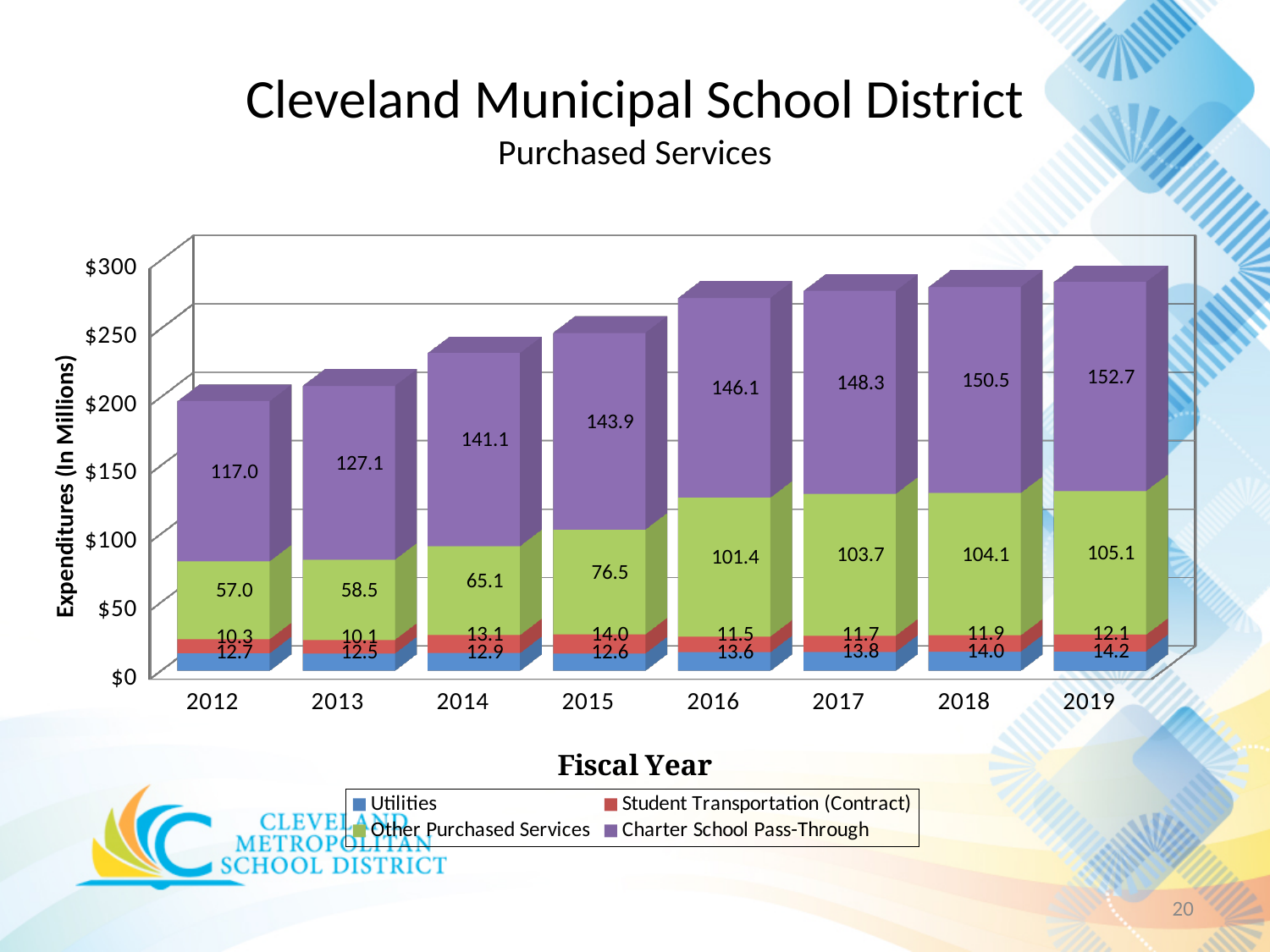
What is the Student Transportation (Contract) value for fiscal year 2015? 14.0 Which fiscal year has the highest Charter School Pass-Through value? 2019 How many series does the legend list? 4 What is the total of the stacked bar for fiscal year 2012? 197.0 What kind of chart is shown on the slide? Stacked bar chart What is the Charter School Pass-Through value for fiscal year 2016? 146.1 How many fiscal years are shown on the x axis? 8 What is the Other Purchased Services value for fiscal year 2014? 65.1 What is the Utilities value for fiscal year 2019? 14.2 What is the difference between the Charter School Pass-Through values for 2019 and 2012? 35.7 Which fiscal year has the lowest Other Purchased Services value? 2012 Is the Other Purchased Services value larger in 2015 or in 2016? 2016